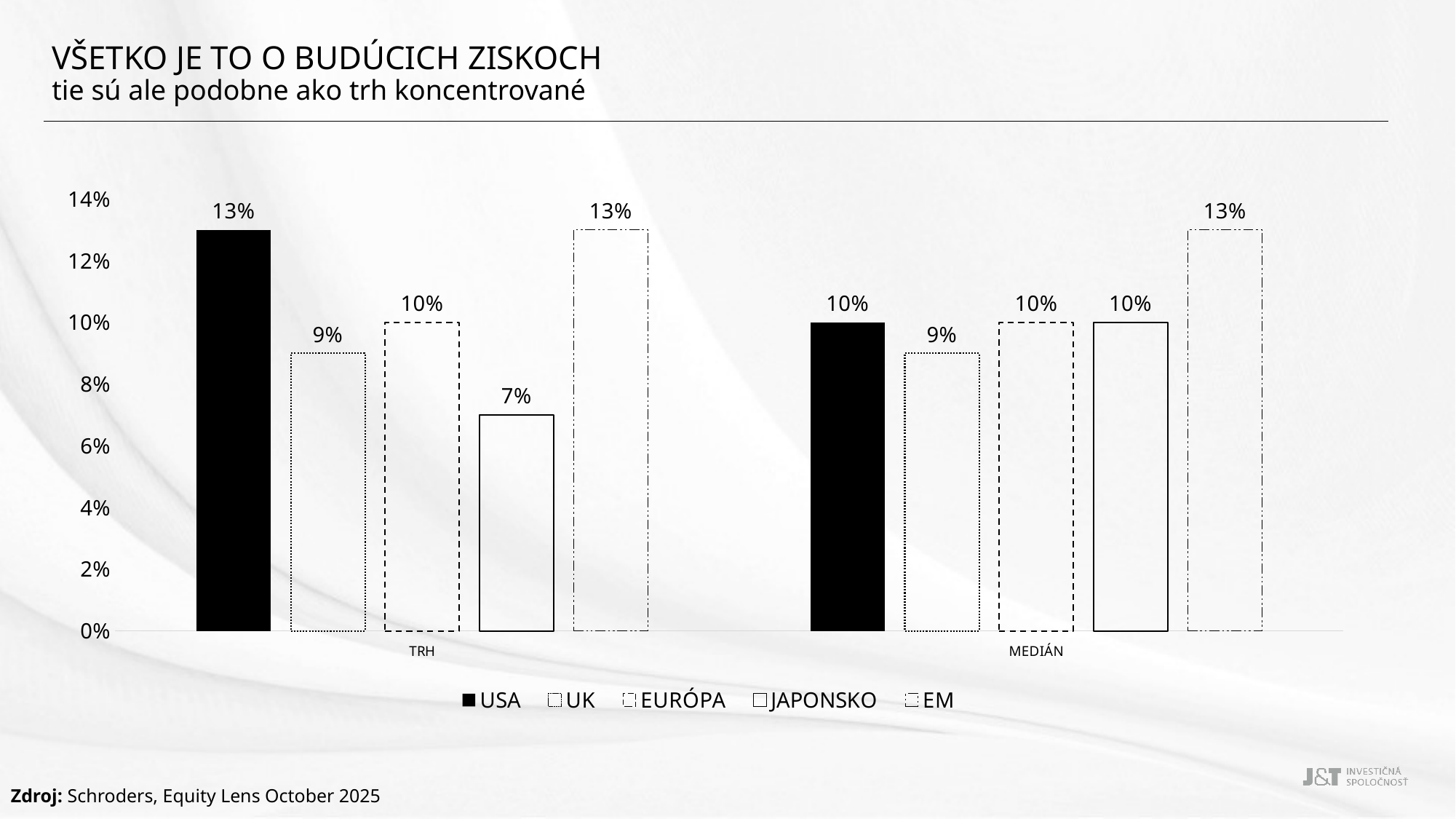
What kind of chart is shown on the slide? Bar chart What is the value for EM in the MEDIÁN category? 13% How many categories are shown on the x axis? 2 Which series has the lowest value in the TRH category? JAPONSKO What is the value for JAPONSKO in the TRH category? 7% How many series does the legend list? 5 What is the value for USA in the TRH category? 13% What is the difference between the USA value and the JAPONSKO value in the TRH category? 6% What is the value for UK in the MEDIÁN category? 9% What is the source cited at the bottom of the slide? Schroders, Equity Lens October 2025 Which series has the highest value in the MEDIÁN category? EM Which is larger in the MEDIÁN category, the value for USA or the value for UK? USA